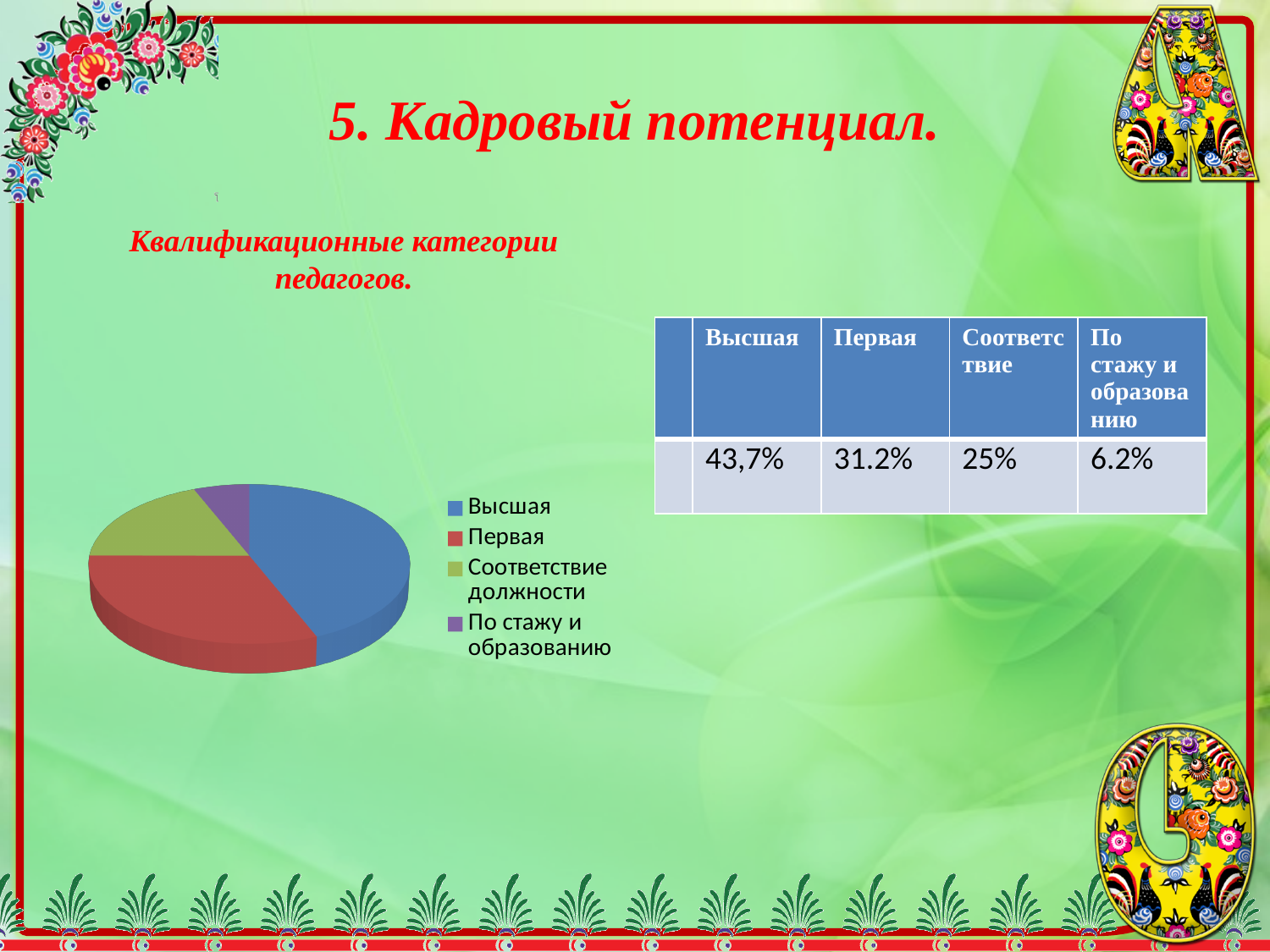
Using the table values, what is the difference between Первая and Соответствие? 6.2% Which slice is larger, Высшая or Первая? Высшая What colour is the Высшая slice in the pie chart? blue Which slice is larger, Первая or Соответствие должности? Первая According to the table on the slide, what is the value for Соответствие? 25% Which category has the largest slice in the pie chart? Высшая Which category has the smallest slice in the pie chart? По стажу и образованию What kind of chart is shown on the slide? pie chart According to the table on the slide, what is the value for По стажу и образованию? 6.2% According to the table on the slide, what share of teachers have the Первая category? 31.2% According to the table on the slide, what share of teachers have the Высшая category? 43,7% How many slices does the pie chart have? 4